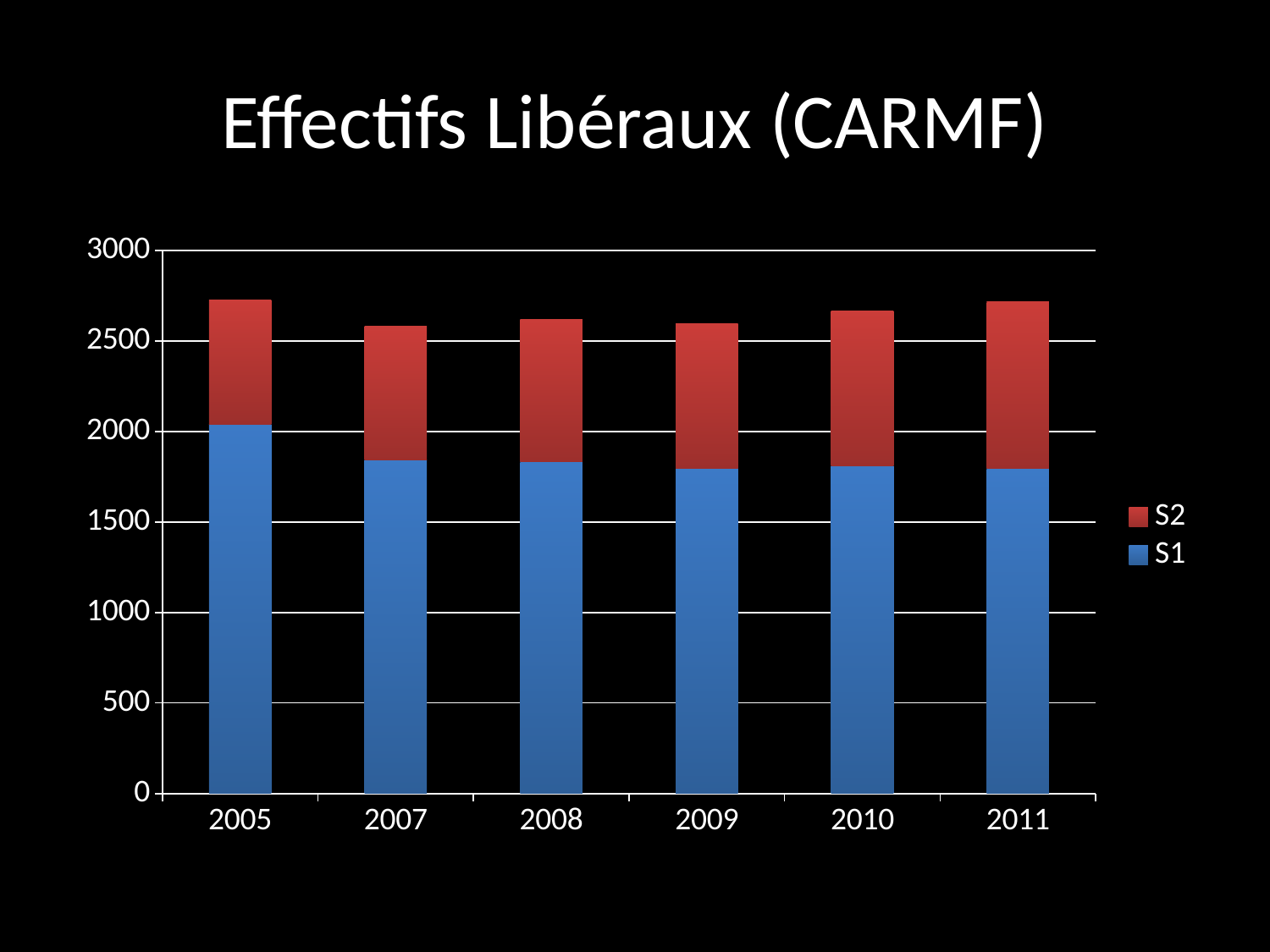
How many years are shown on the x axis? 6 Which year has the larger total stacked value, 2005 or 2007? 2005 Which series is shown in blue? S1 Is the total stacked value for 2007 greater or less than 2500? greater Is the S1 value for 2007 greater or less than 2000? less In 2005, which series has the larger value, S1 or S2? S1 Is the total stacked value for 2005 greater or less than 3000? less What kind of chart is shown on the slide? Stacked bar chart What is the title of the chart? Effectifs Libéraux (CARMF) Which year has the highest S1 value? 2005 How many series does the legend list? 2